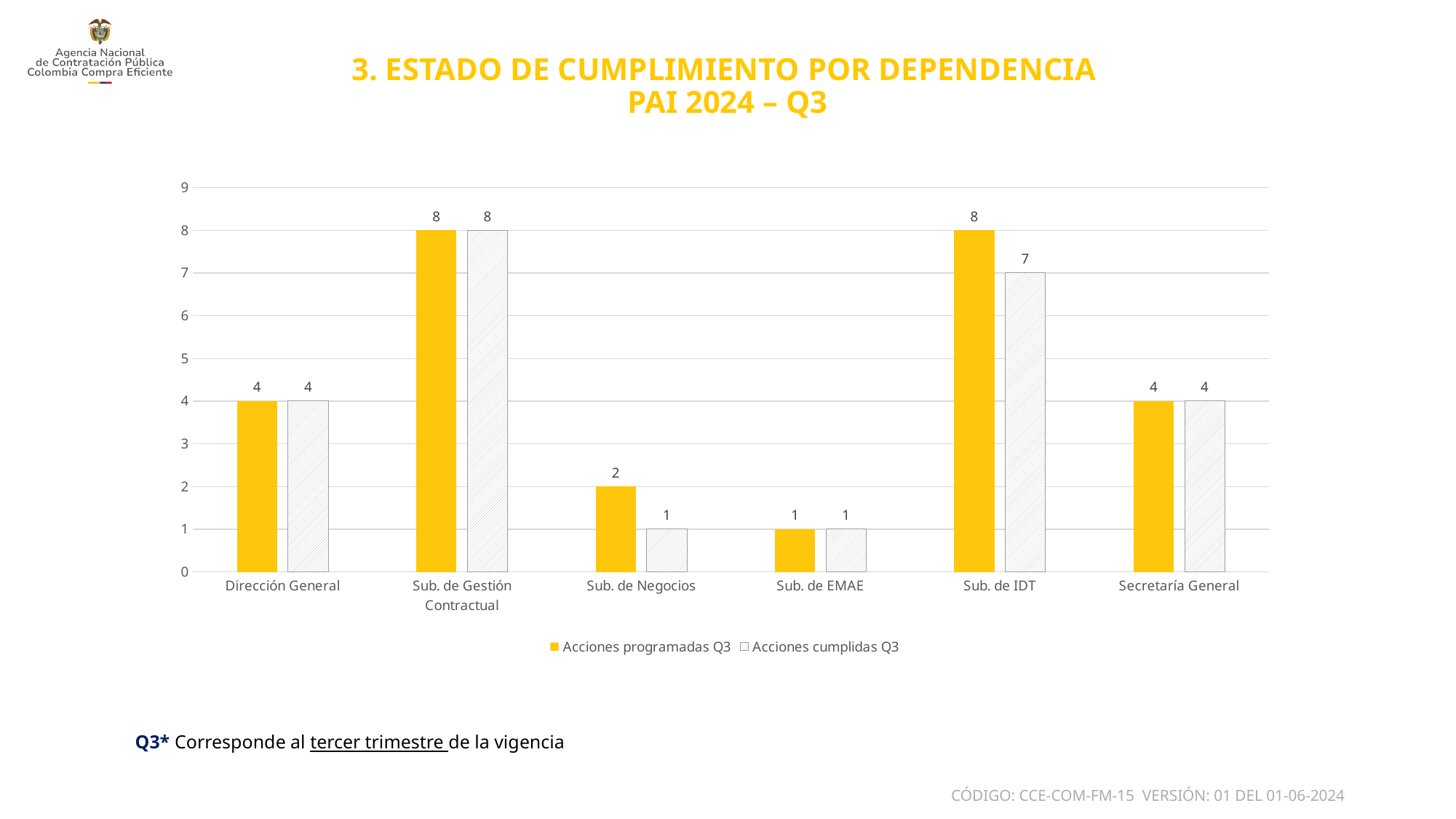
What kind of chart is shown on the slide? Bar chart How many categories are shown on the x axis? 6 What is the difference between Acciones programadas Q3 and Acciones cumplidas Q3 for Sub. de Negocios? 1 What is the difference between Acciones programadas Q3 and Acciones cumplidas Q3 for Sub. de IDT? 1 What is the value of Acciones cumplidas Q3 for Sub. de Negocios? 1 Which category has the lowest value for Acciones programadas Q3? Sub. de EMAE What is the value of Acciones cumplidas Q3 for Sub. de IDT? 7 Which is larger for Sub. de Negocios: Acciones programadas Q3 or Acciones cumplidas Q3? Acciones programadas Q3 What is the value of Acciones programadas Q3 for Dirección General? 4 How many series does the legend list? 2 Which colour represents Acciones programadas Q3 in the chart? Yellow What is the value of Acciones programadas Q3 for Sub. de IDT? 8